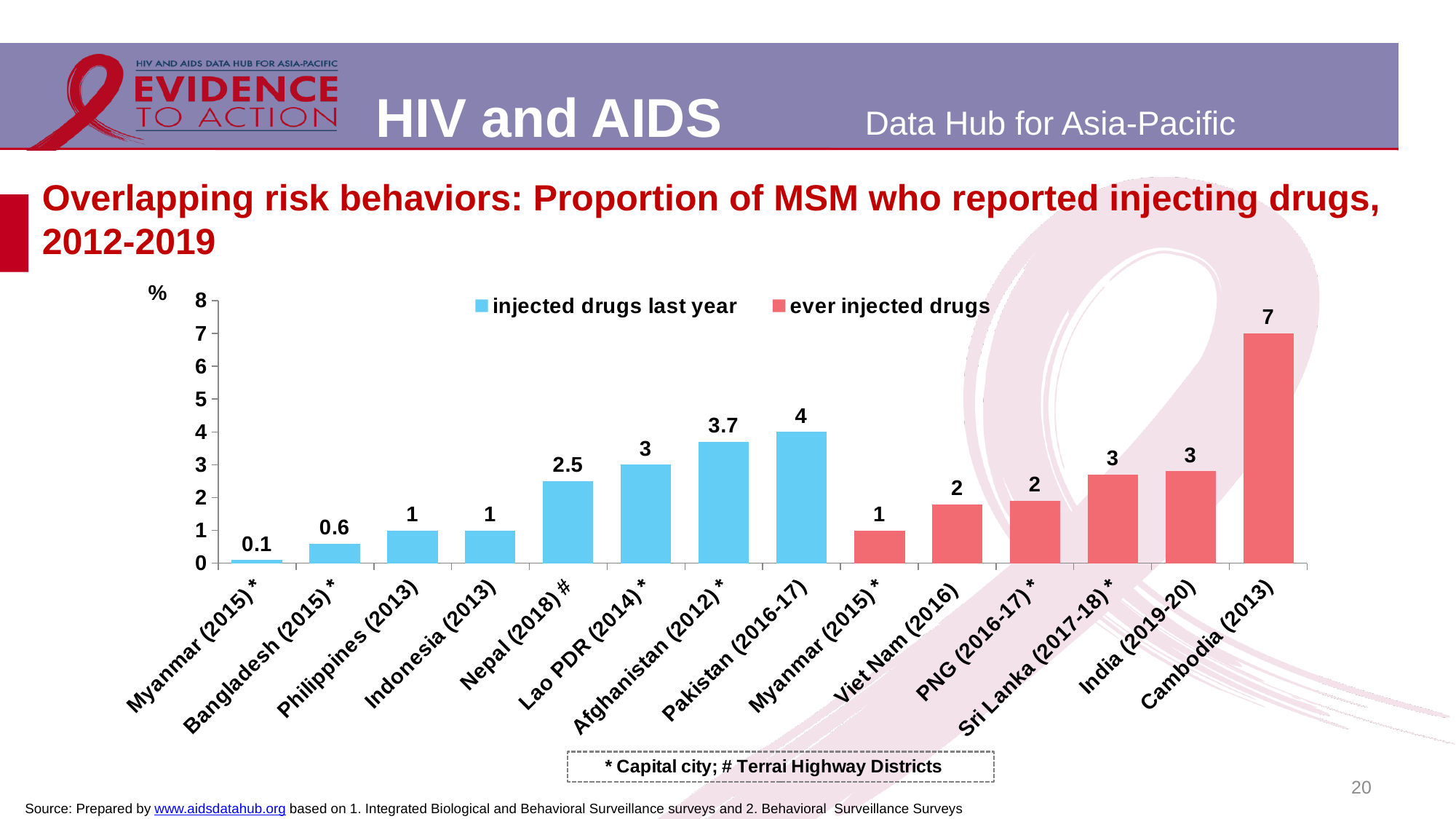
What is the value for Afghanistan (2012)* in the injected drugs last year series? 3.7 Which country has the highest bar on the chart? Cambodia (2013) What kind of chart is shown on the slide? Bar chart What is the difference between the value for Cambodia (2013) and the value for Pakistan (2016-17)? 3 How many bars are plotted on the chart? 14 What is the value for Nepal (2018)# in the injected drugs last year series? 2.5 What is the value for Bangladesh (2015)* in the injected drugs last year series? 0.6 Which is larger: the value for Lao PDR (2014)* or the value for Bangladesh (2015)*? Lao PDR (2014)* How many series does the legend list? 2 Which bar has the lowest value on the chart? Myanmar (2015)* (injected drugs last year) What is the value for Cambodia (2013) in the ever injected drugs series? 7 Which country has the highest value in the injected drugs last year series? Pakistan (2016-17)